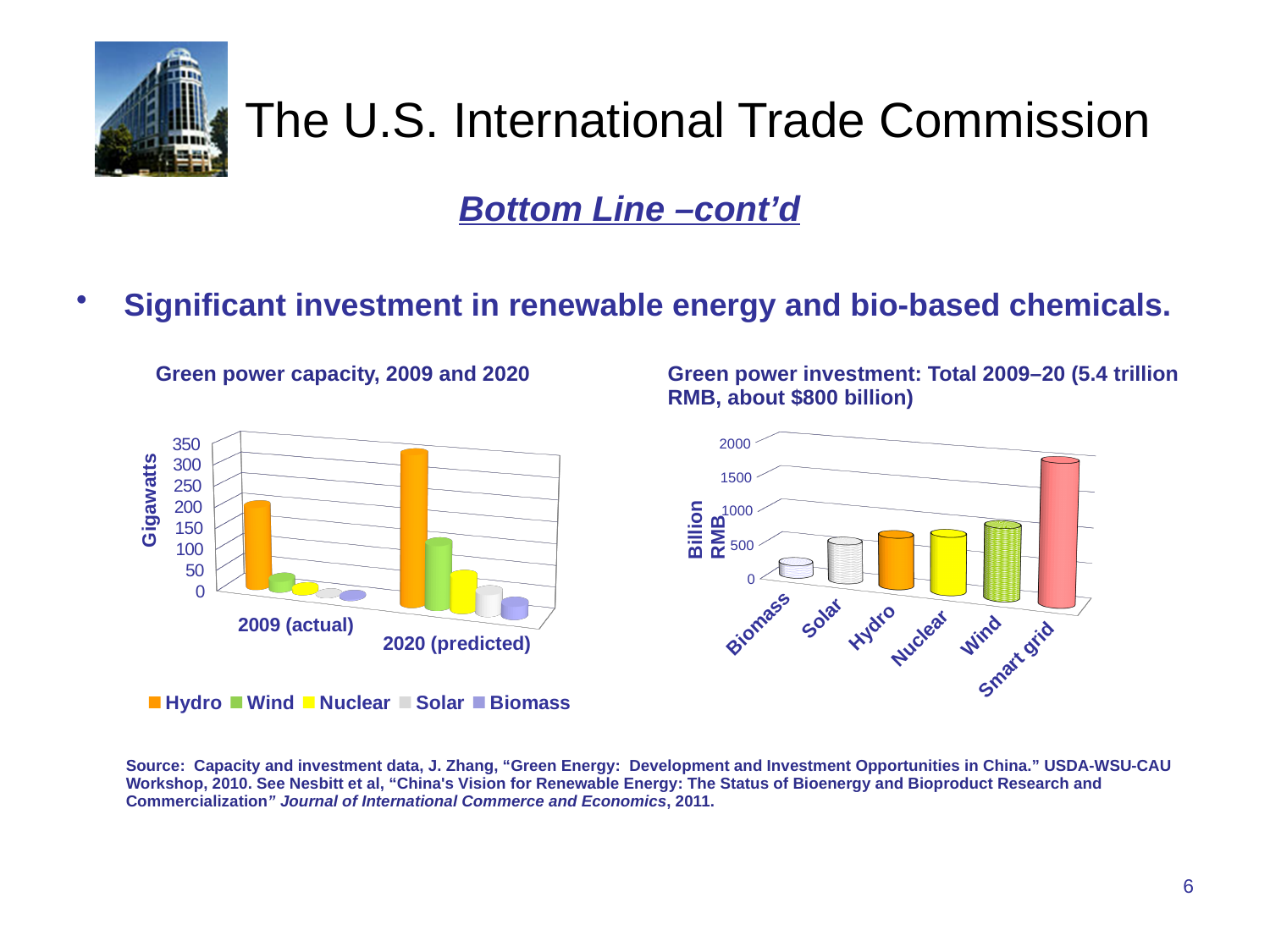
How many series does the legend of the 'Green power capacity, 2009 and 2020' chart list? 5 On the 'Green power capacity, 2009 and 2020' chart, is the Hydro value for 2009 (actual) greater or less than 100? greater On the 'Green power capacity, 2009 and 2020' chart, is the Hydro value for 2020 (predicted) greater or less than 250? greater On the 'Green power investment' chart, is the value for Smart grid greater or less than 1000? greater On the 'Green power investment' chart, which category has the lowest value? Biomass On the 'Green power capacity, 2009 and 2020' chart, which series has the highest value for 2020 (predicted)? Hydro On the 'Green power investment' chart, which category has the highest value? Smart grid How many categories are shown on the 'Green power investment' chart? 6 On the 'Green power capacity, 2009 and 2020' chart, which is larger for 2020 (predicted): Hydro or Wind? Hydro What unit is shown on the vertical axis of the 'Green power capacity, 2009 and 2020' chart? Gigawatts On the 'Green power capacity, 2009 and 2020' chart, which series has the lowest value for 2020 (predicted)? Biomass